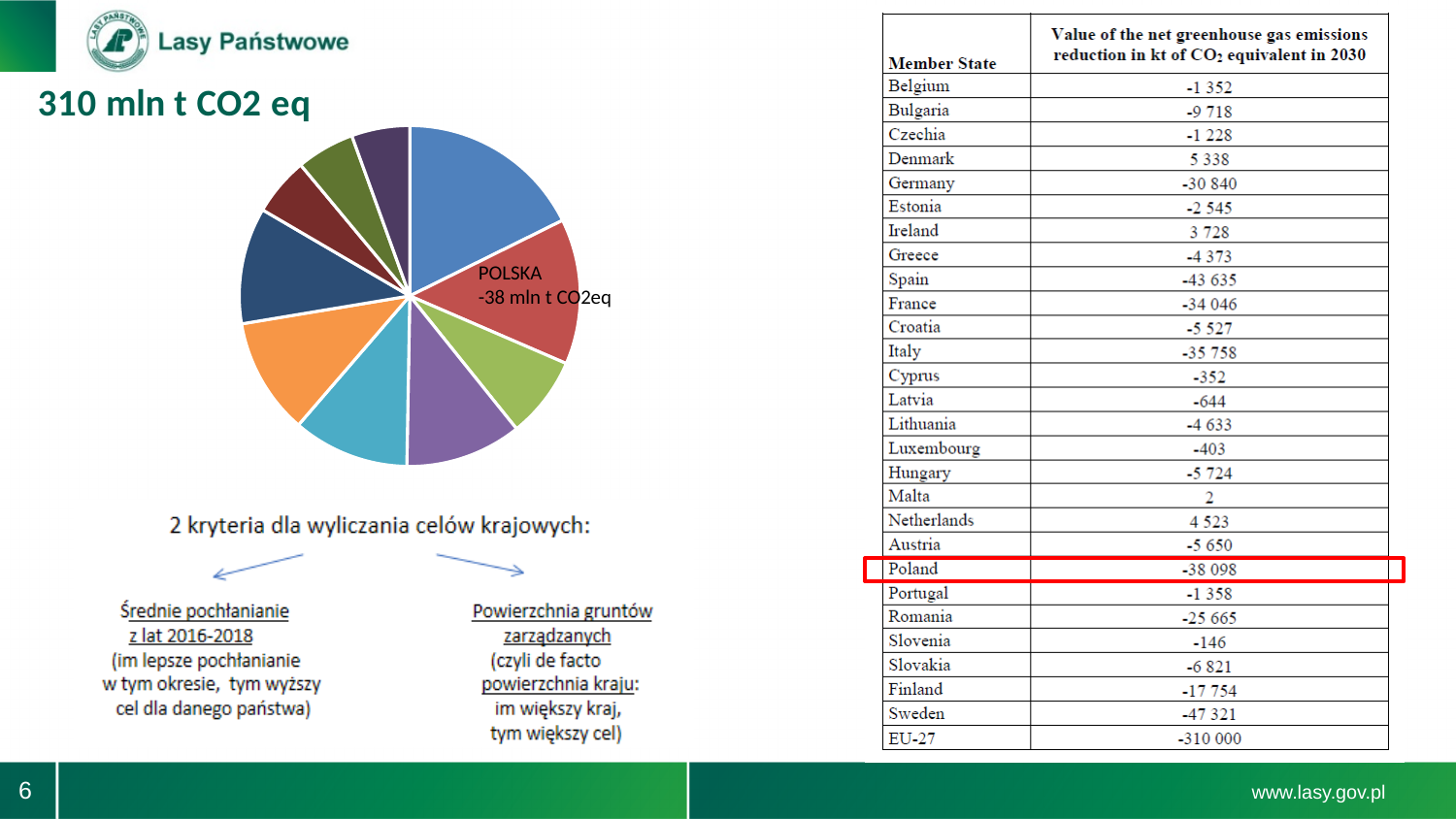
What kind of chart is shown on the left of the slide? pie chart Which slice of the pie chart is larger, the blue slice or the POLSKA slice? the blue slice Is the POLSKA slice the largest slice of the pie chart? No How many slices does the pie chart have? 10 What colour is the POLSKA slice of the pie chart? red What value is labelled on the POLSKA slice of the pie chart? -38 mln t CO2eq What is the title shown above the pie chart? 310 mln t CO2 eq Which country is the only one labelled on the pie chart? POLSKA